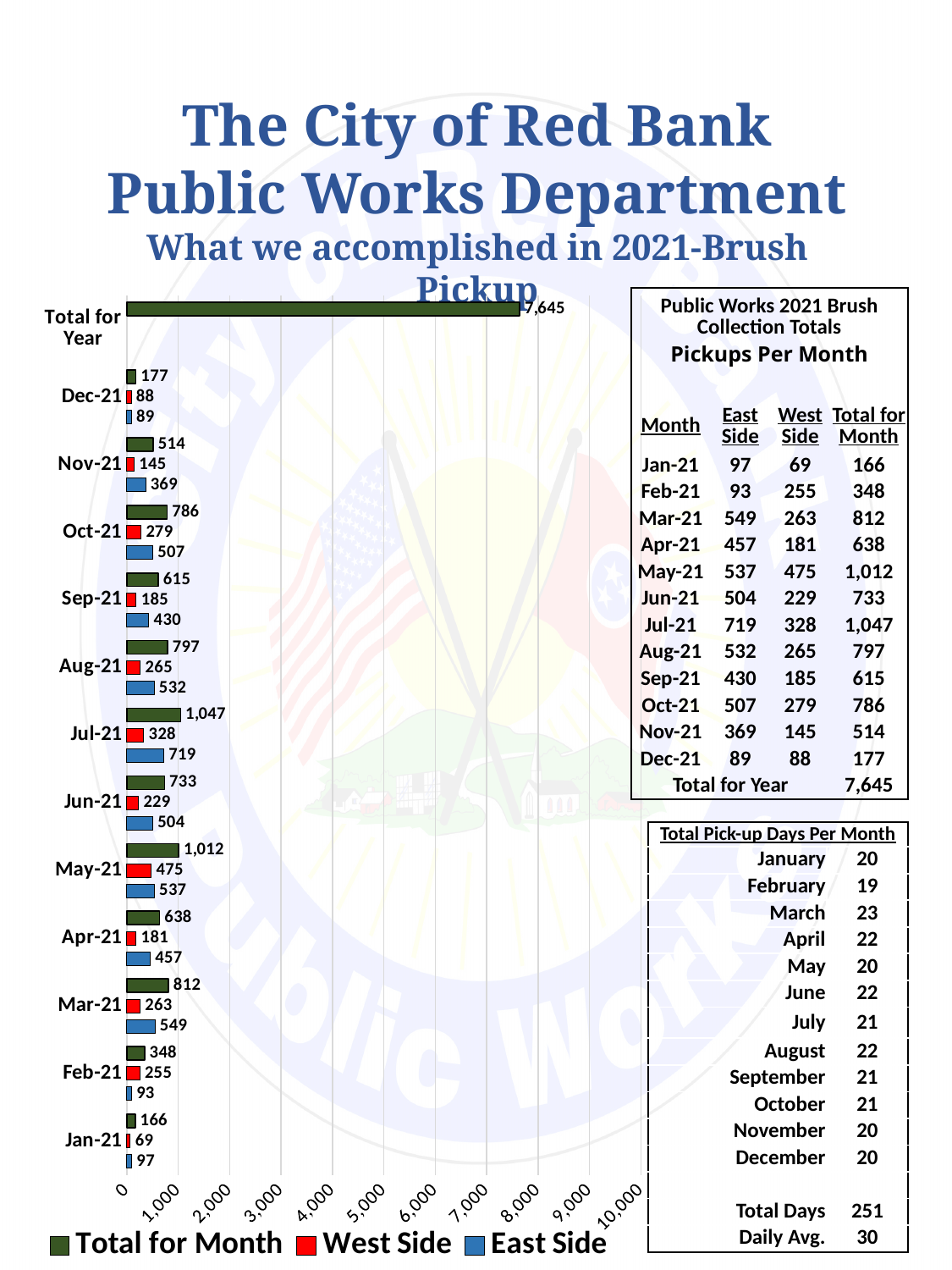
Which month has the highest West Side value? May-21 What is the West Side value for May-21? 475 What is the Total for Month value for Mar-21? 812 Which is larger for Aug-21, the East Side value or the West Side value? East Side What kind of chart is shown on the slide? bar chart Which month has the highest East Side value? Jul-21 What is the value of the Total for Year bar? 7,645 How many months are shown on the chart? 12 What is the East Side value for Jul-21? 719 What is the difference between the Total for Month values for Oct-21 and Nov-21? 272 How many series does the legend list? 3 Is the Total for Year value greater or less than 7,000? greater